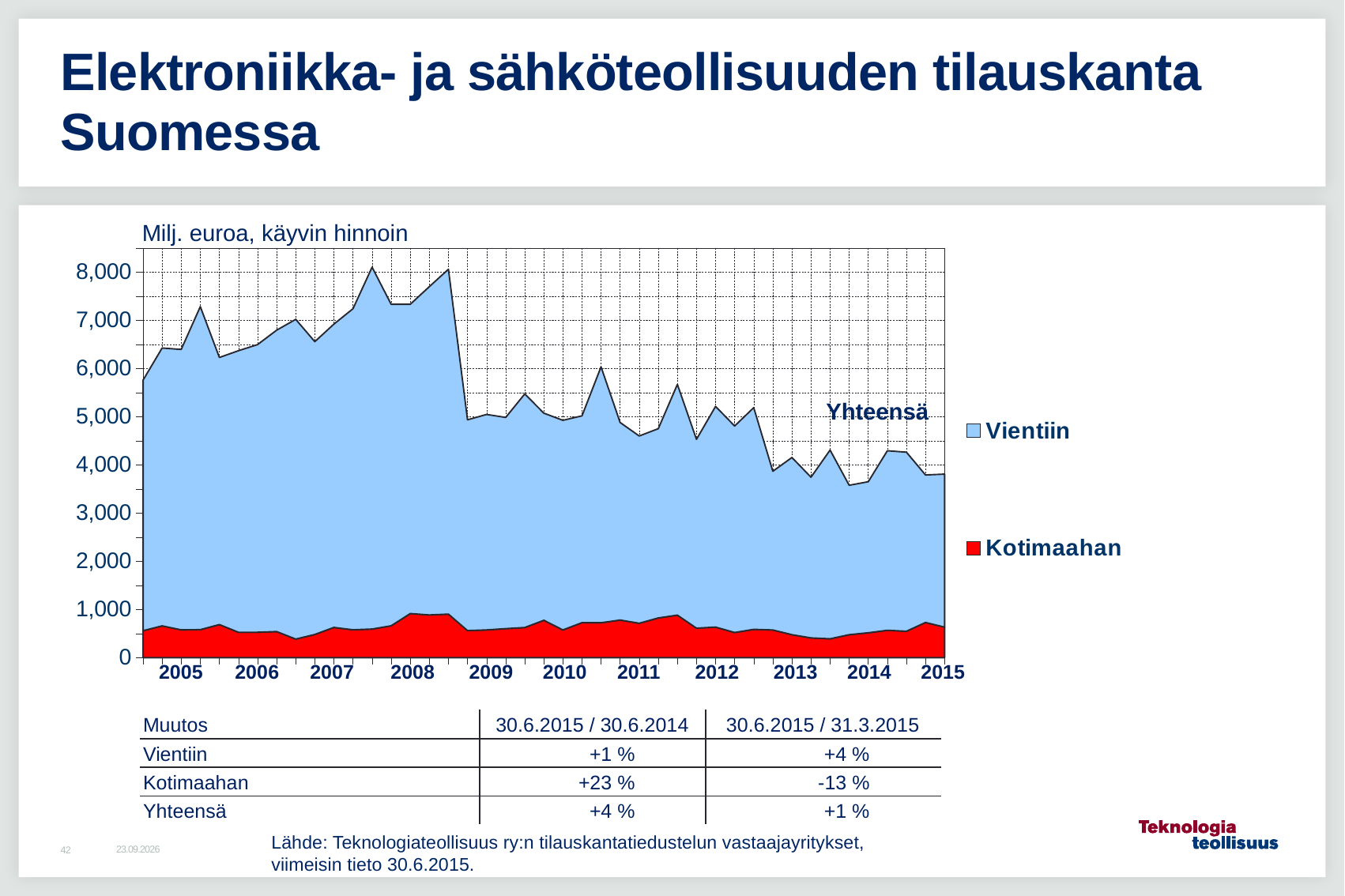
How many year labels are shown on the x axis? 11 What unit is stated above the chart? Milj. euroa, käyvin hinnoin Does the total order backlog (Yhteensä) rise or fall overall from 2005 to 2015? Fall What kind of chart is shown on the slide? Area chart Is the Kotimaahan series ever greater than 1,000 on the chart? No, it stays less than 1,000 Is the total value during 2007 greater or less than 6,000? greater Which two series are listed in the chart legend? Vientiin and Kotimaahan Which series is larger throughout the chart, Vientiin or Kotimaahan? Vientiin Is the total value at the start of 2005 greater or less than 5,000? greater How many series does the chart legend list? 2 According to the table below the chart, what is the change for Kotimaahan from 30.6.2014 to 30.6.2015? +23 %